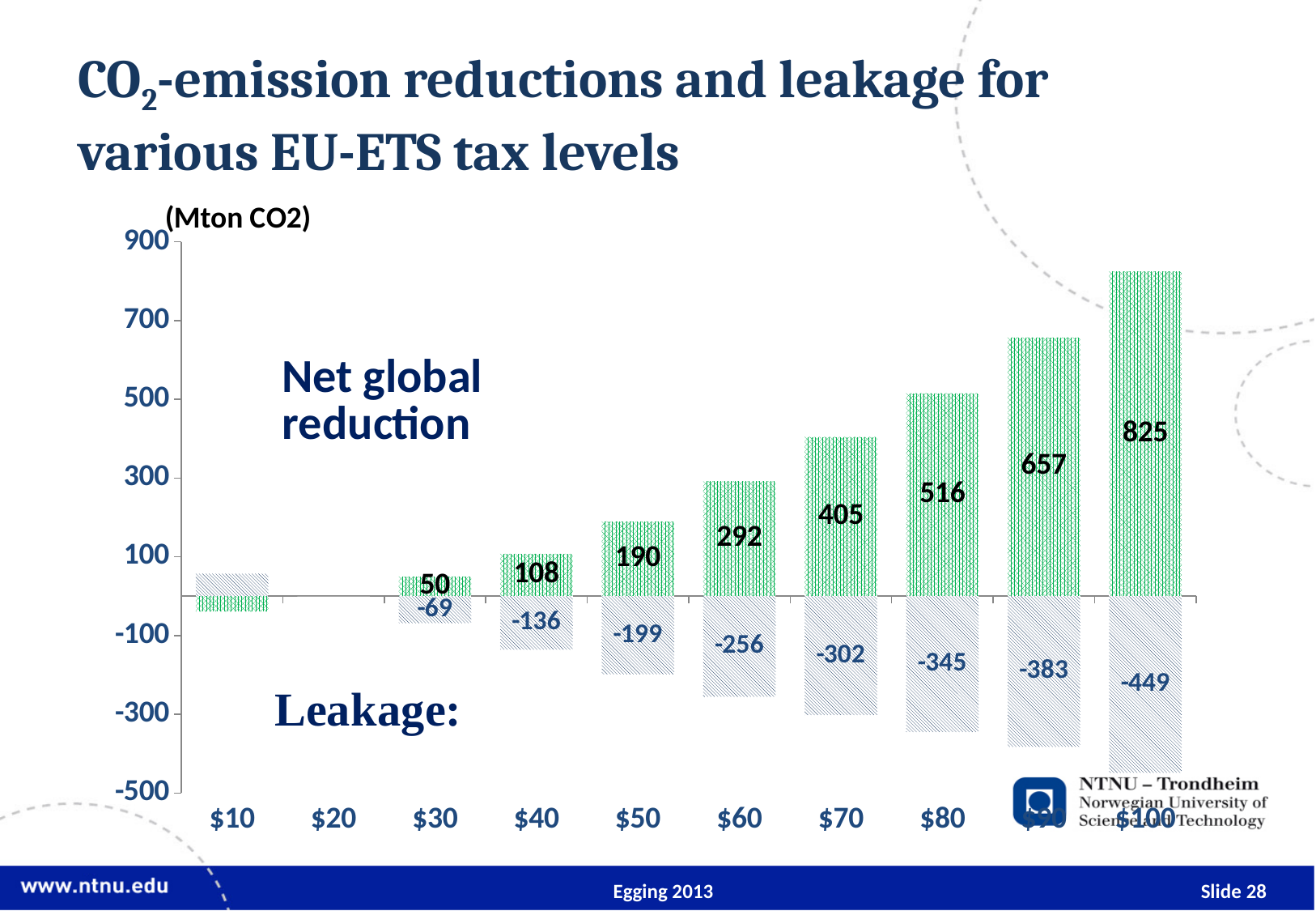
Is the net global reduction at the $10 tax level greater or less than 100? less What is the leakage value at the $60 tax level? -256 What is the leakage value at the $80 tax level? -345 Does the net global reduction rise or fall as the tax level increases from $30 to $100? rises What is the net global reduction at the $40 tax level? 108 What unit is shown for the values on the chart? Mton CO2 How many tax levels are shown on the x axis? 10 What kind of chart is shown on the slide? bar chart What is the difference between the net global reduction at $100 and at $80? 309 Which tax level has the larger net global reduction, $50 or $70? $70 What is the net global reduction at the $100 tax level? 825 At which tax level is the net global reduction highest? $100